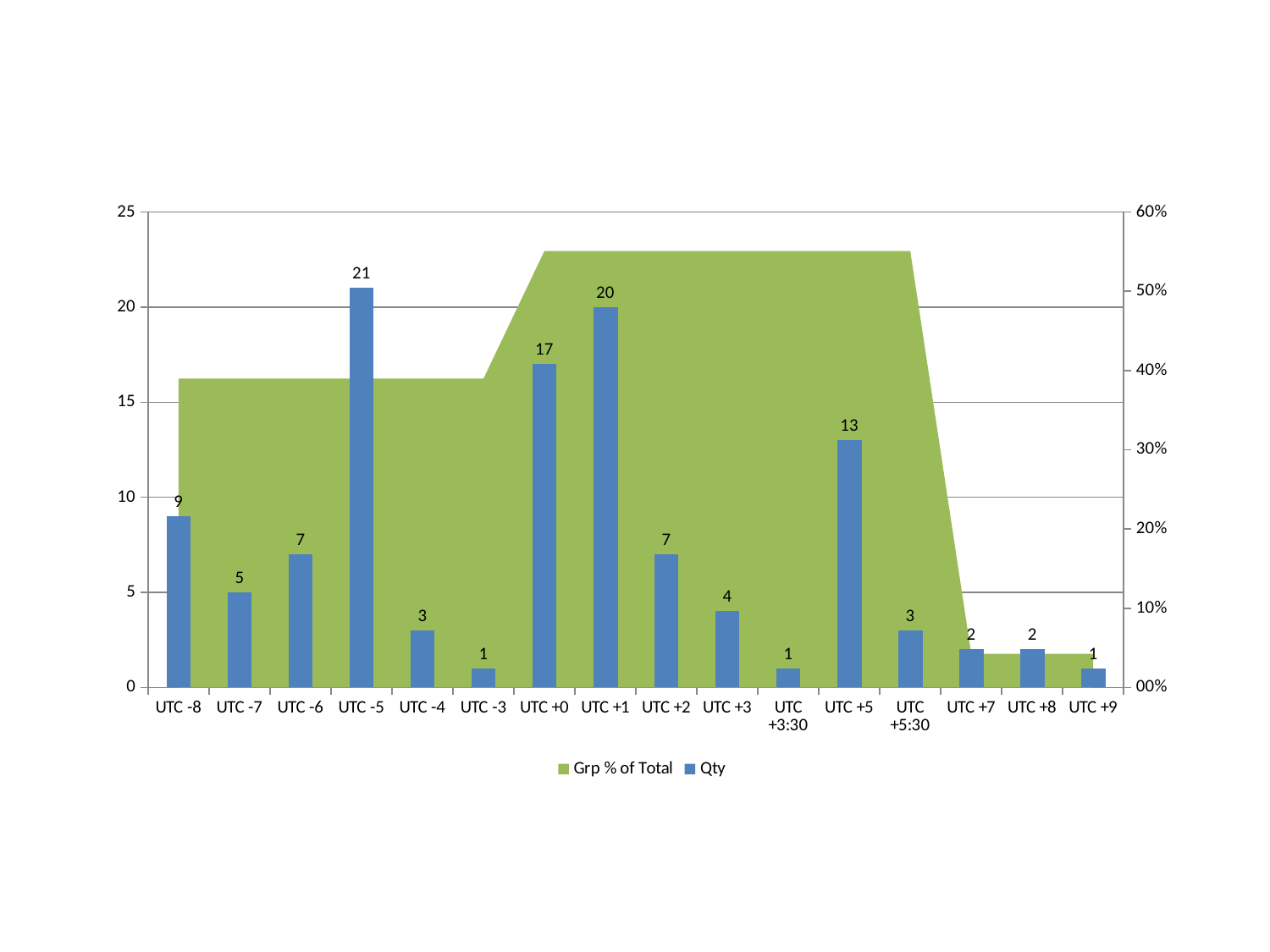
How many series does the legend list? 2 What is the Qty value for UTC -5? 21 What is the Qty value for UTC +5? 13 What is the Qty value for UTC +3:30? 1 What is the difference in Qty between UTC +0 and UTC +5? 4 Is the Grp % of Total value for UTC +1 greater or less than 50%? greater Which series is shown in green? Grp % of Total Which category has the highest Qty? UTC -5 How many categories are shown on the x axis? 16 Is the Grp % of Total value for UTC +8 greater or less than 10%? less What is the difference in Qty between UTC -5 and UTC +1? 1 Which has a larger Qty, UTC -8 or UTC -6? UTC -8